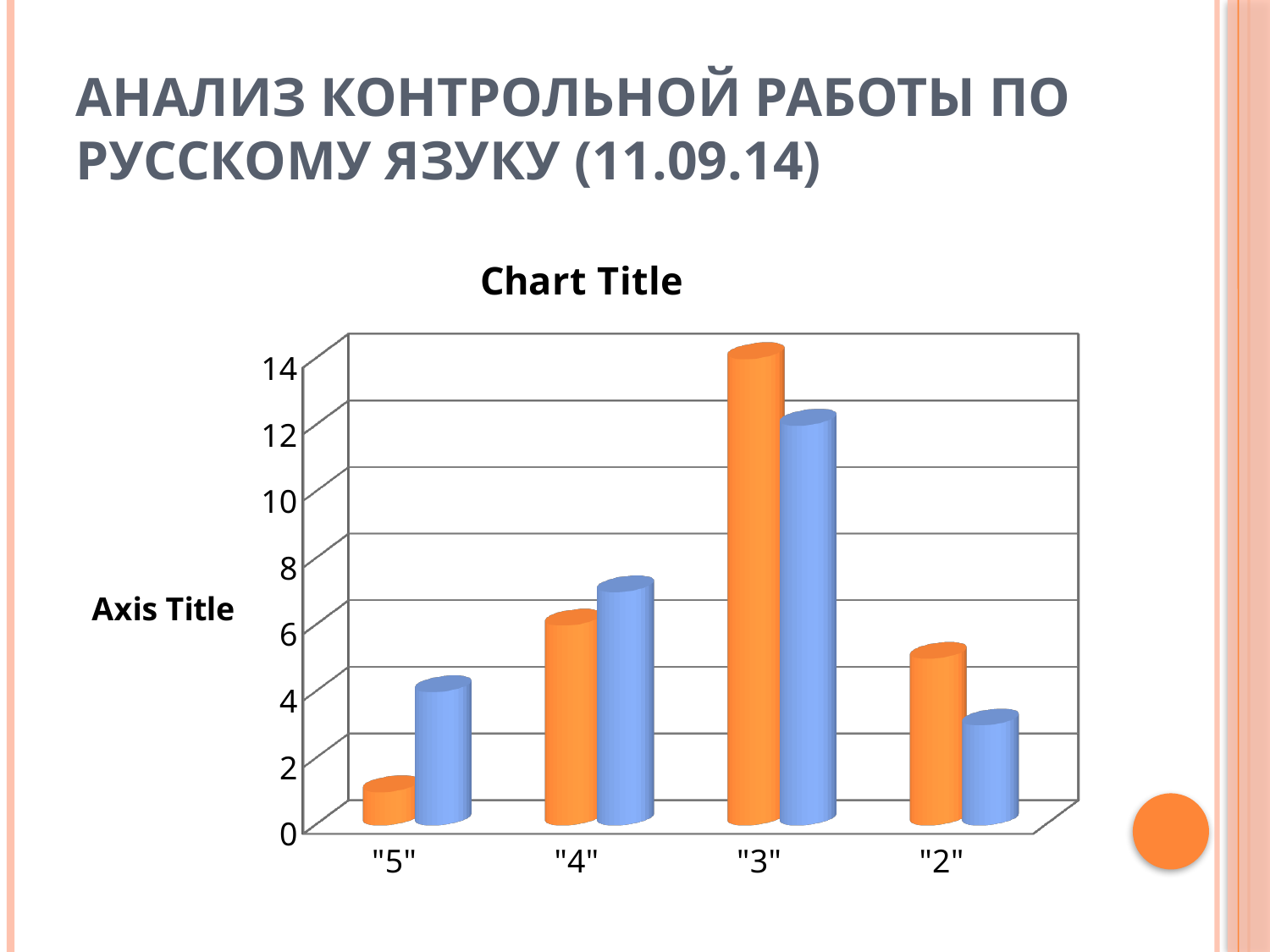
Which category has the tallest orange bar? "3" Which category has the shortest orange bar? "5" For category "5", which bar is taller, the orange one or the blue one? blue Which category has the tallest blue bar? "3" For category "2", which bar is taller, the orange one or the blue one? orange What is the title shown above the chart? Chart Title Is the orange bar for "4" greater or less than 8? less What kind of chart is shown on the slide? bar chart Which category has the shortest blue bar? "2" Is the blue bar for "5" greater or less than 6? less How many categories are shown on the horizontal axis of the chart? 4 Is the orange bar for "3" greater or less than 12? greater